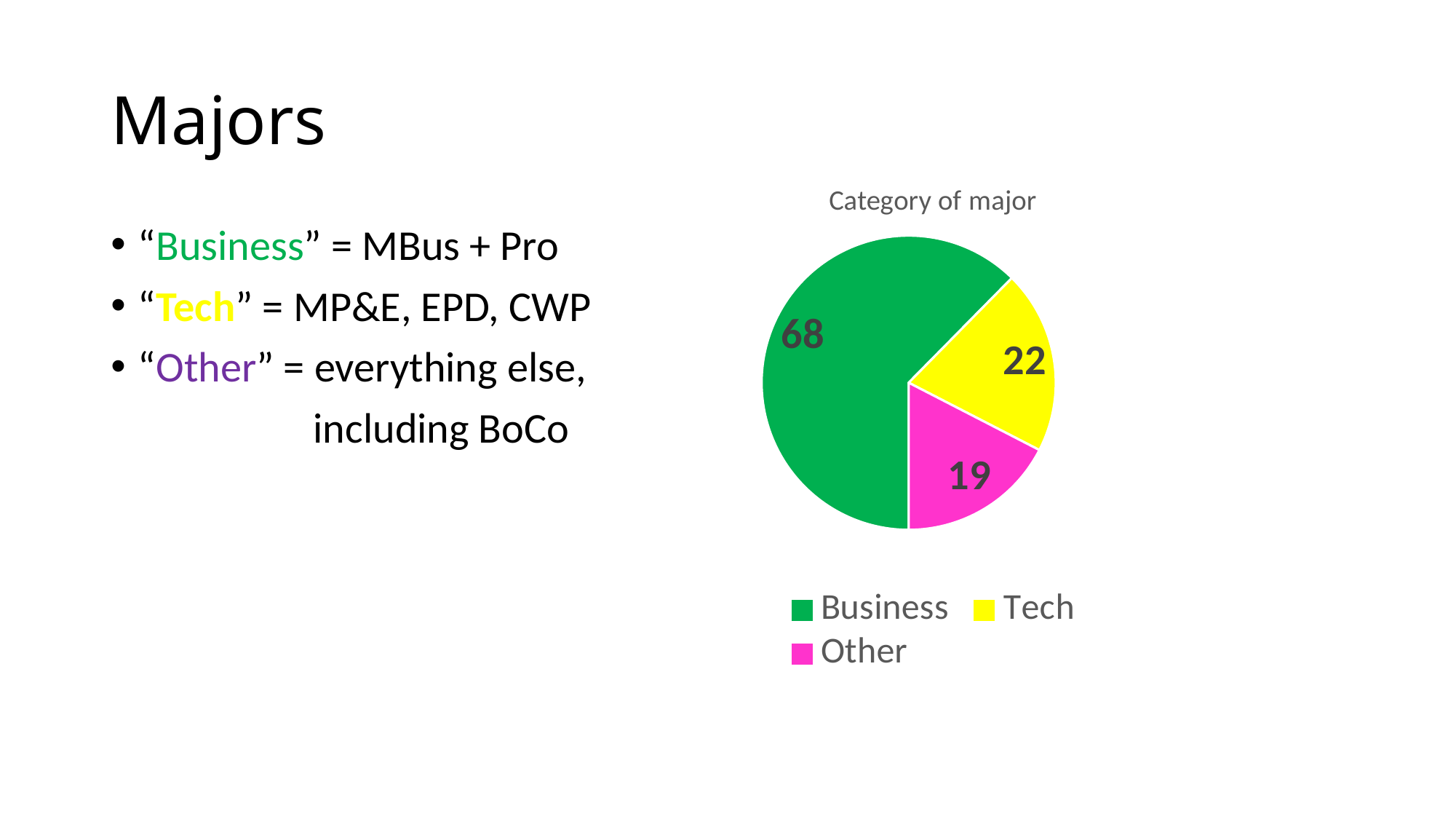
What is the value for Tech in the pie chart? 22 What is the difference between the Business and Tech values? 46 What is the difference between the Tech and Other values? 3 What is the value for Business in the pie chart? 68 What is the total of all slices in the pie chart? 109 What is the value for Other in the pie chart? 19 What kind of chart is shown on the slide? Pie chart Which is larger, the value for Tech or the value for Other? Tech What is the title of the chart? Category of major Which category has the largest slice in the pie chart? Business Which category has the smallest slice in the pie chart? Other How many categories are shown in the pie chart? 3